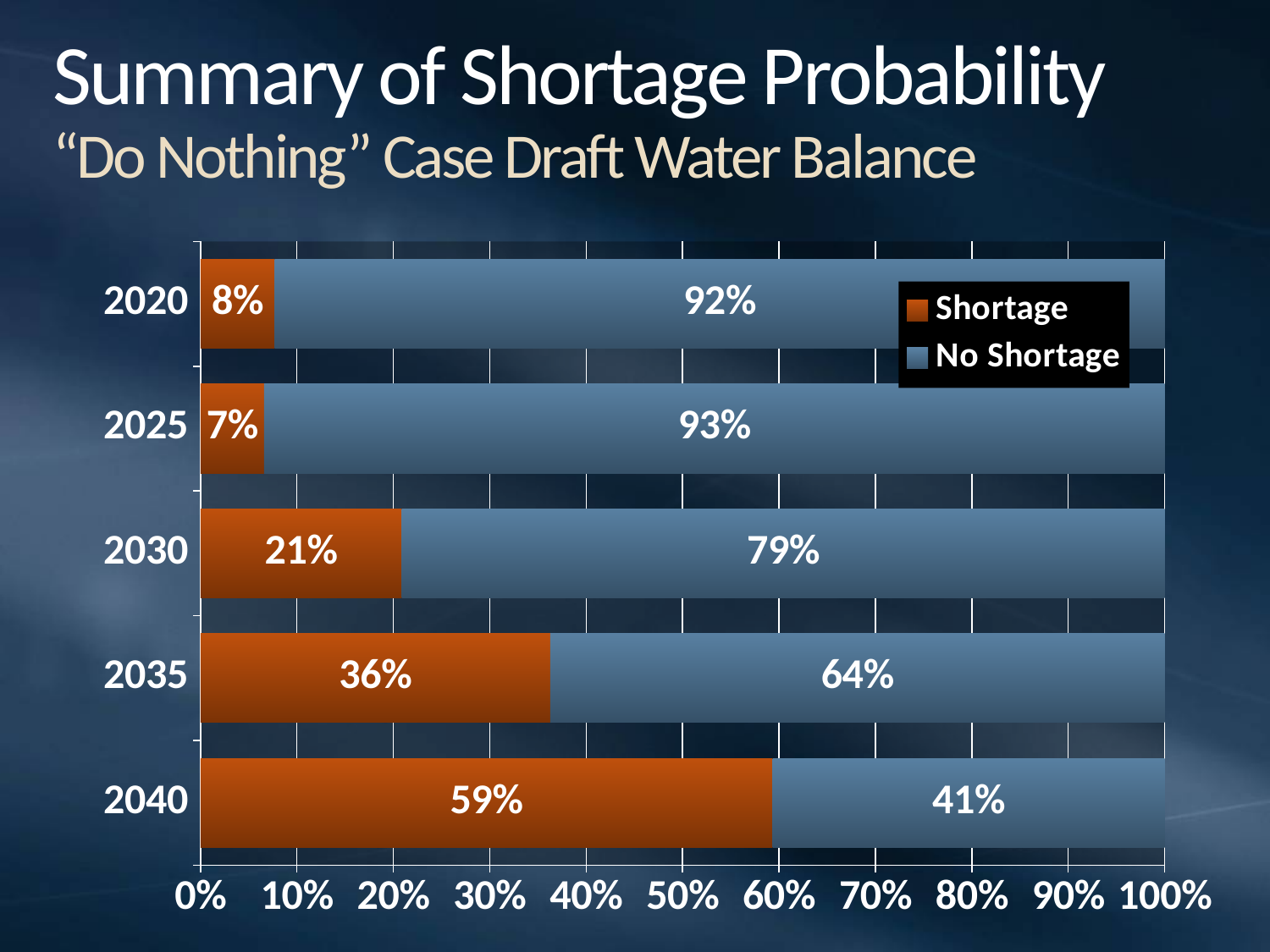
Which year has the lowest Shortage probability? 2025 What is the Shortage probability for 2030? 21% How many series does the legend list? 2 What is the difference between the Shortage values for 2040 and 2035? 23% What colour represents the Shortage series in the legend? Orange Which year has the highest Shortage probability? 2040 What kind of chart is shown on the slide? Bar chart How many years are shown on the chart? 5 Which is larger, the No Shortage value for 2020 or for 2030? 2020 What is the Shortage value for 2040? 59% Does the Shortage probability rise or fall from 2025 to 2040? Rise What is the No Shortage value for 2035? 64%